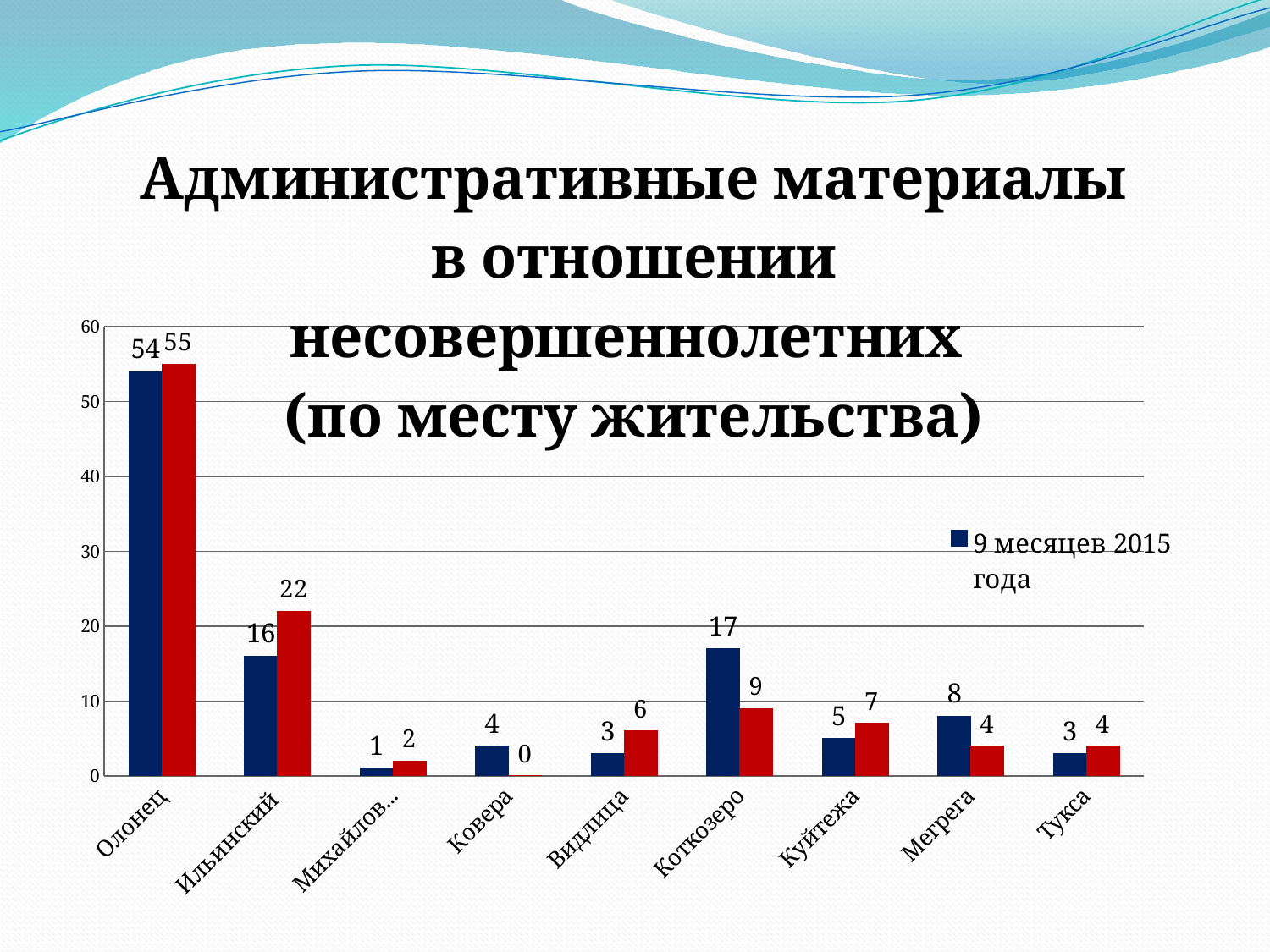
What is the value for Коткозеро in the series '9 месяцев 2015 года'? 17 What legend entry is shown for the dark blue series? 9 месяцев 2015 года What is the value of the red bar for Ильинский? 22 Which category has the highest value in the series '9 месяцев 2015 года'? Олонец What is the value of the red bar for Ковера? 0 What is the value for Олонец in the series '9 месяцев 2015 года'? 54 For Коткозеро, which is larger: the '9 месяцев 2015 года' bar or the red bar? 9 месяцев 2015 года Is the value for Олонец in the series '9 месяцев 2015 года' greater or less than 50? greater How many categories are shown on the x axis of the chart? 9 What is the difference between the red bar and the '9 месяцев 2015 года' bar for Ильинский? 6 What kind of chart is shown on the slide? bar chart Which category has the lowest value in the series '9 месяцев 2015 года'? Михайлов...